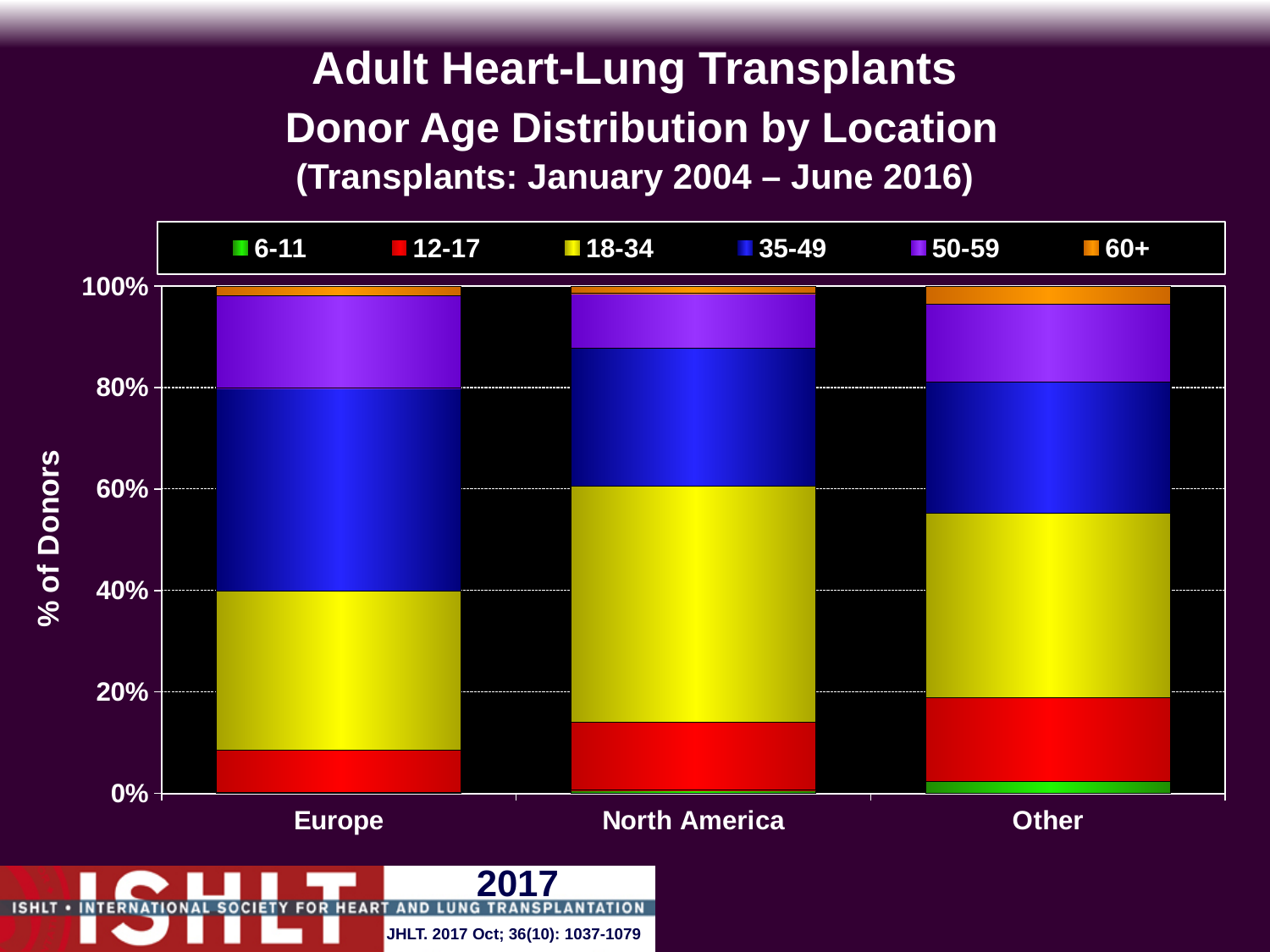
Is the 35-49 share of donors for Other greater or less than 40%? less Which location has the smallest 12-17 segment? Europe Which is larger, the 12-17 share for Other or for Europe? Other Is the 12-17 share of donors for Europe greater or less than 20%? less What is the label of the y axis? % of Donors How many donor age groups does the legend list? 6 Which location has the largest 35-49 segment? Europe Is the 18-34 share of donors for North America greater or less than 40%? greater What kind of chart is shown on the slide? stacked bar chart Which location has the largest 18-34 segment? North America How many locations are shown on the x axis? 3 Which is larger, the 50-59 share for Europe or for North America? Europe